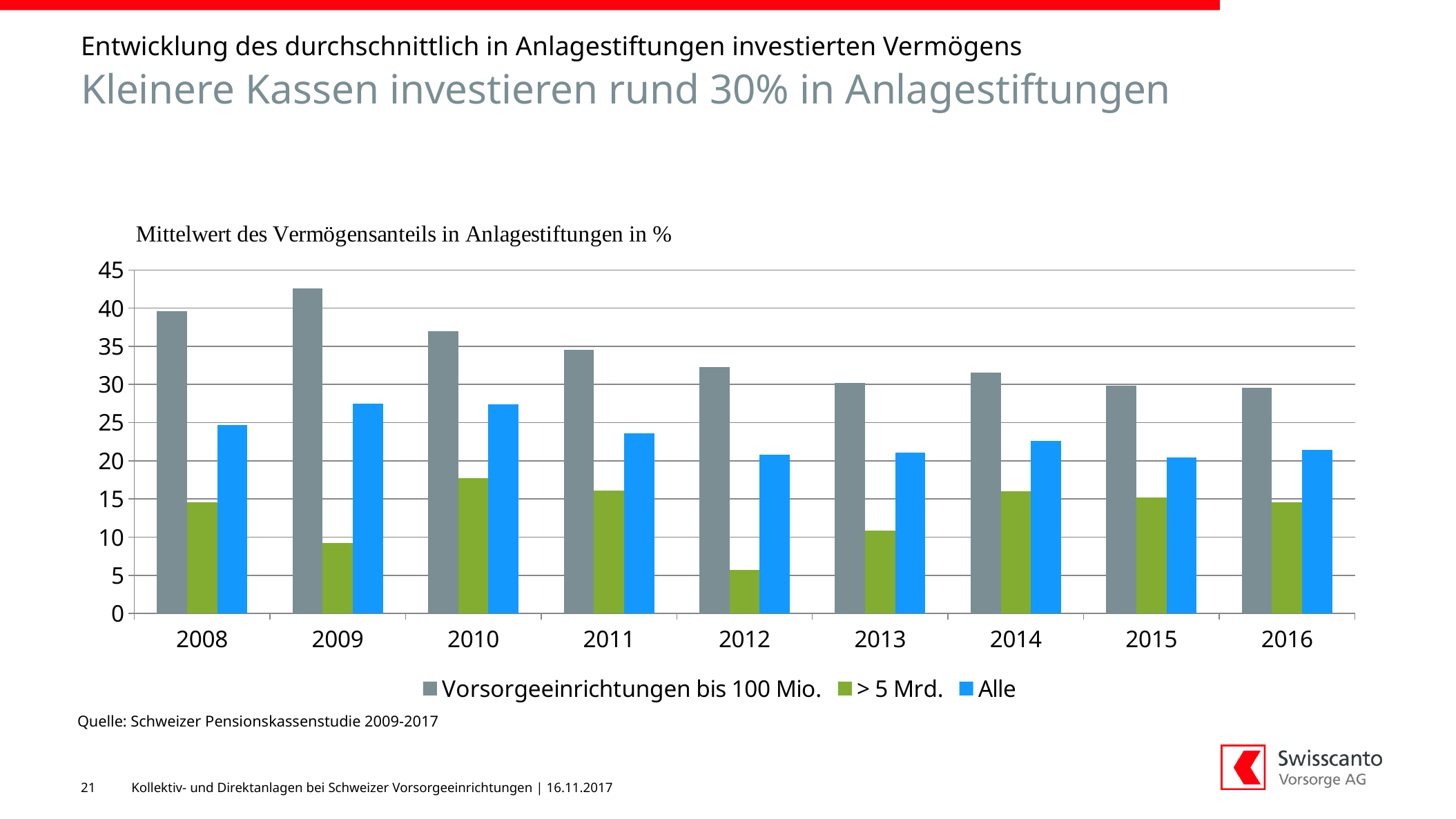
In which year is the value for 'Vorsorgeeinrichtungen bis 100 Mio.' highest? 2009 What kind of chart is shown on the slide? bar chart In which year is the value for '> 5 Mrd.' lowest? 2012 How many years are shown on the x axis? 9 Is the value for 'Alle' in 2011 greater or less than 25? less Does the value for 'Vorsorgeeinrichtungen bis 100 Mio.' generally rise or fall from 2008 to 2016? fall How many series does the legend list? 3 Is the value for 'Vorsorgeeinrichtungen bis 100 Mio.' in 2009 greater or less than 40? greater Which is larger in 2008: the value for 'Vorsorgeeinrichtungen bis 100 Mio.' or the value for 'Alle'? Vorsorgeeinrichtungen bis 100 Mio. In which year is the value for '> 5 Mrd.' highest? 2010 Is the value for '> 5 Mrd.' in 2012 greater or less than 10? less